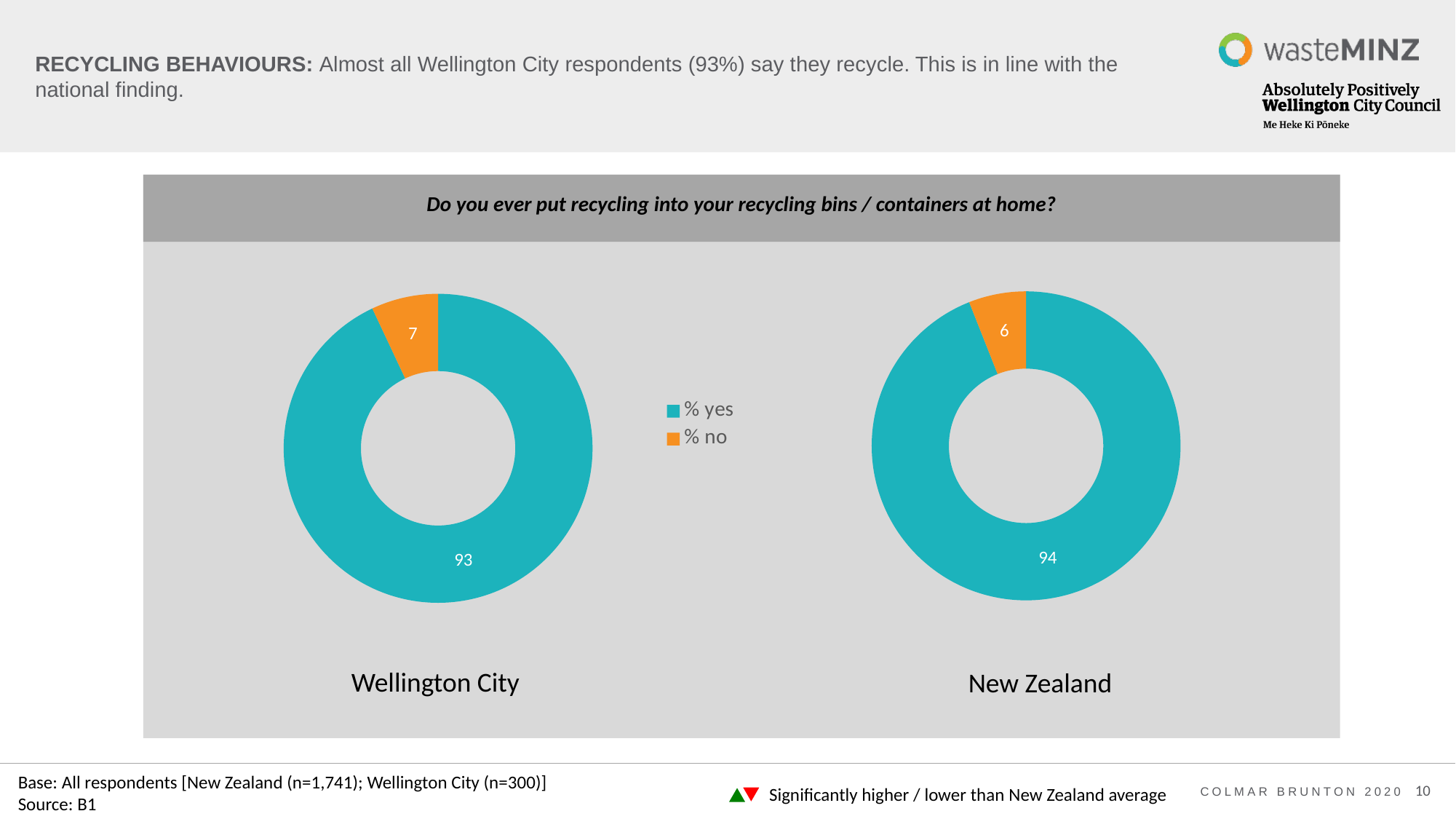
In the New Zealand chart, which category is the smallest? % no In the New Zealand chart, what is the value for % no? 6 How many categories does the Wellington City chart show? 2 In the Wellington City chart, which category is the largest? % yes In the Wellington City chart, what is the difference between % yes and % no? 86 What question is shown as the title above the two charts? Do you ever put recycling into your recycling bins / containers at home? What kind of chart is the New Zealand chart? Donut chart How many entries does the legend list? 2 In the Wellington City chart, what is the value for % yes? 93 In the Wellington City chart, what is the value for % no? 7 Comparing the two charts, which has the larger % no value, Wellington City or New Zealand? Wellington City In the New Zealand chart, what is the value for % yes? 94